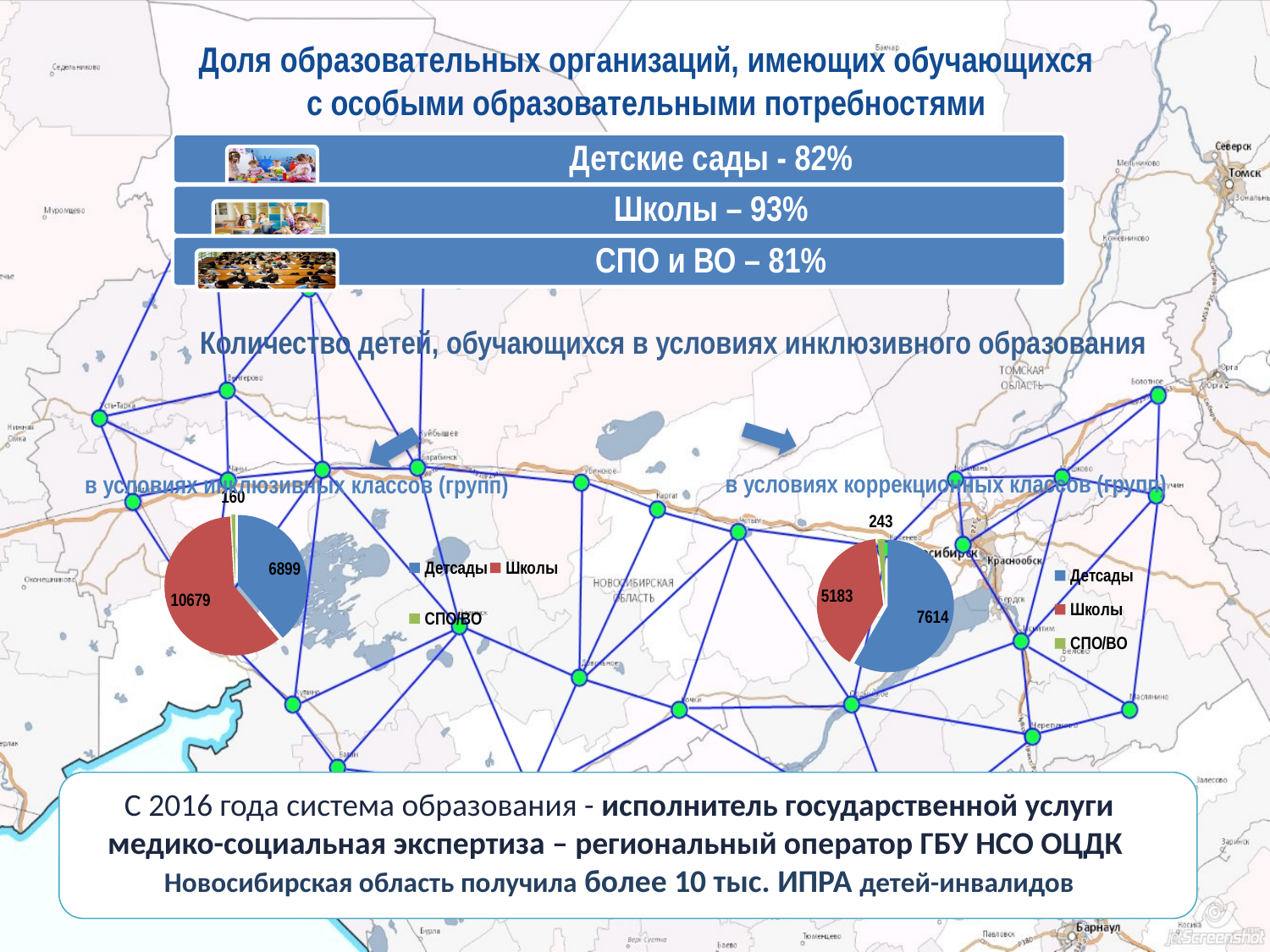
In the left pie chart (в условиях инклюзивных классов (групп)), what is the difference between the values for Школы and Детсады? 3780 In the right pie chart (в условиях коррекционных классов (групп)), which category has the smallest value? СПО/ВО How many categories does the legend of the right pie chart (в условиях коррекционных классов (групп)) list? 3 In the left pie chart (в условиях инклюзивных классов (групп)), what is the value for Школы? 10679 In the right pie chart (в условиях коррекционных классов (групп)), what is the value for СПО/ВО? 243 In the right pie chart (в условиях коррекционных классов (групп)), what is the value for Детсады? 7614 In the left pie chart (в условиях инклюзивных классов (групп)), which category has the largest value? Школы In the left pie chart (в условиях инклюзивных классов (групп)), what is the value for Детсады? 6899 In the right pie chart (в условиях коррекционных классов (групп)), which category has the largest value? Детсады Which is larger: the value for Школы in the left pie chart or the value for Школы in the right pie chart? Left pie chart (10679) In the right pie chart (в условиях коррекционных классов (групп)), what is the difference between the values for Детсады and Школы? 2431 In the left pie chart (в условиях инклюзивных классов (групп)), what is the value for СПО/ВО? 160